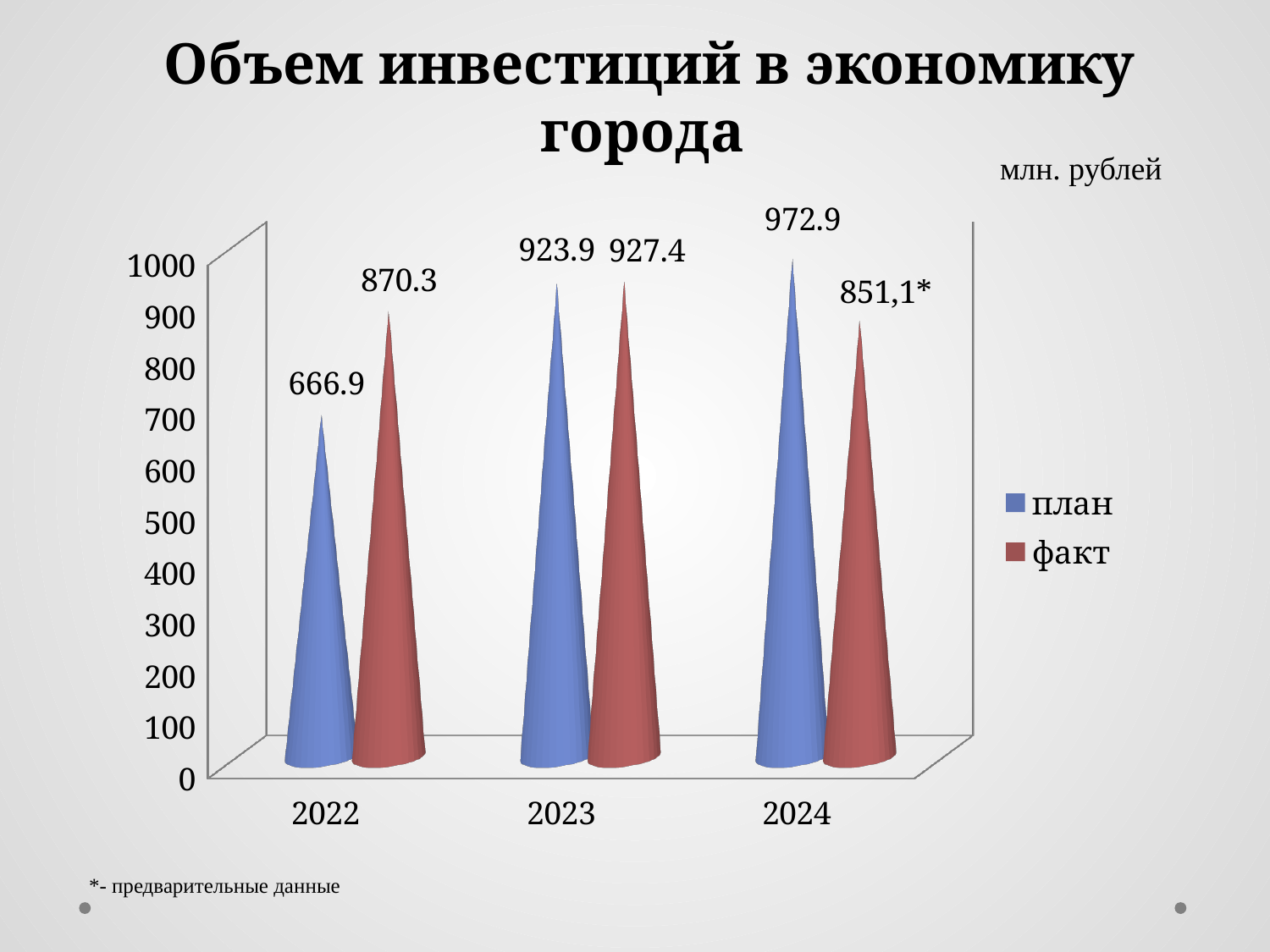
How many series does the legend list? 2 What unit is stated for the values in the chart? млн. рублей Which is larger in 2023, план or факт? факт Does the план value rise or fall from 2022 to 2024? rise What is the план value for 2022? 666.9 Is the план value for 2022 greater or less than 700? less What is the difference between the факт and план values for 2022? 203.4 In which year is the факт value lowest? 2024 What is the факт value for 2023? 927.4 What is the факт value for 2024? 851,1* How many years are shown on the x axis? 3 In which year is the план value highest? 2024